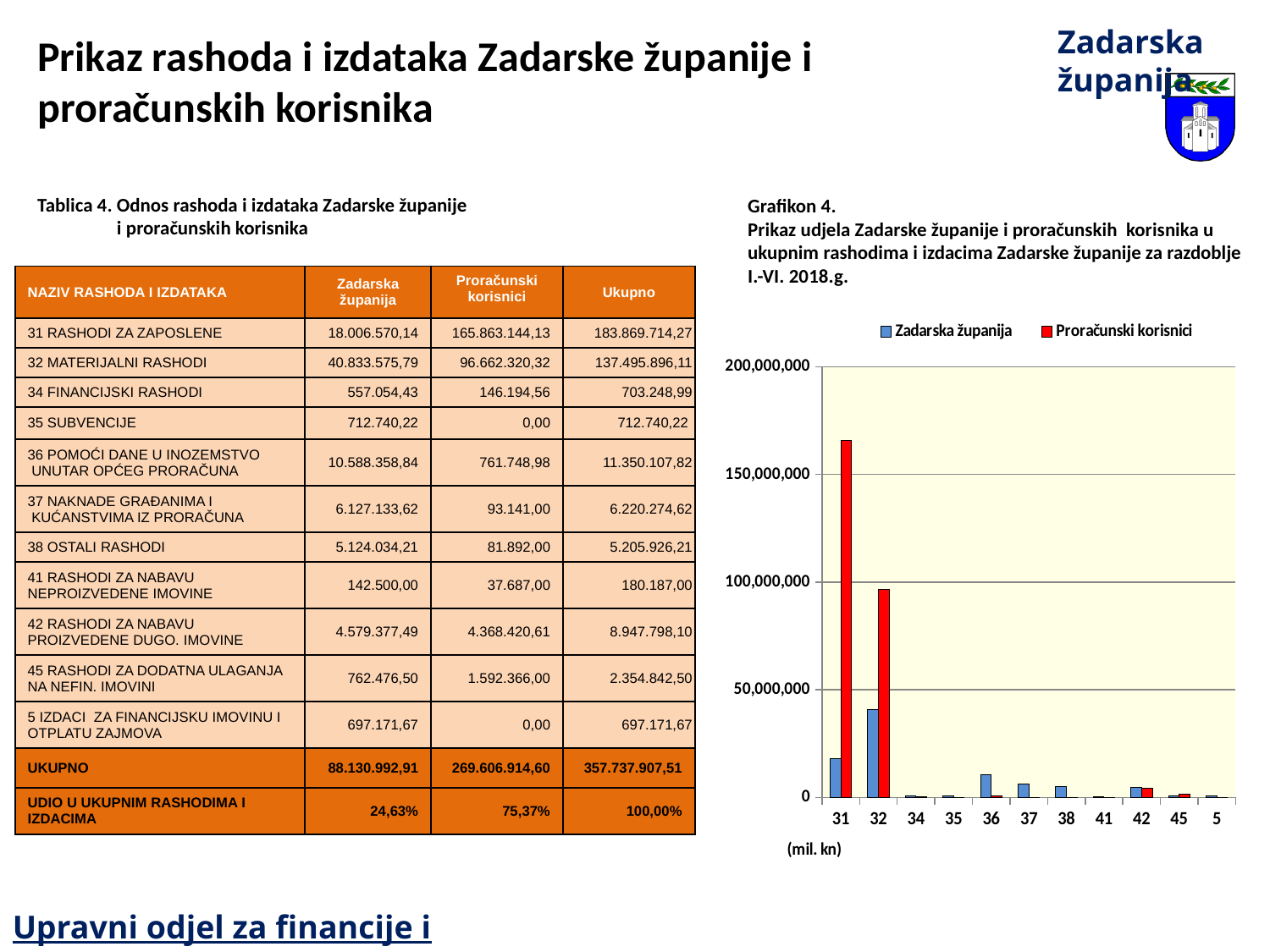
In Grafikon 4, which category has the highest value for Zadarska županija? 32 In Grafikon 4, is the Zadarska županija value for category 31 greater or less than 50,000,000? less What unit label is shown below the x axis of Grafikon 4? (mil. kn) In Grafikon 4, for category 36, which series has the larger value: Zadarska županija or Proračunski korisnici? Zadarska županija How many categories are shown on the x axis of Grafikon 4? 11 What kind of chart is Grafikon 4? bar chart In Grafikon 4, is the Proračunski korisnici value for category 31 greater or less than 150,000,000? greater In Grafikon 4, for category 31, which series has the larger value: Zadarska županija or Proračunski korisnici? Proračunski korisnici How many series does the legend of Grafikon 4 list? 2 In Grafikon 4, which category has the highest value for Proračunski korisnici? 31 In Grafikon 4, which colour represents the Proračunski korisnici series? red In Grafikon 4, is the Zadarska županija value for category 32 greater or less than 50,000,000? less